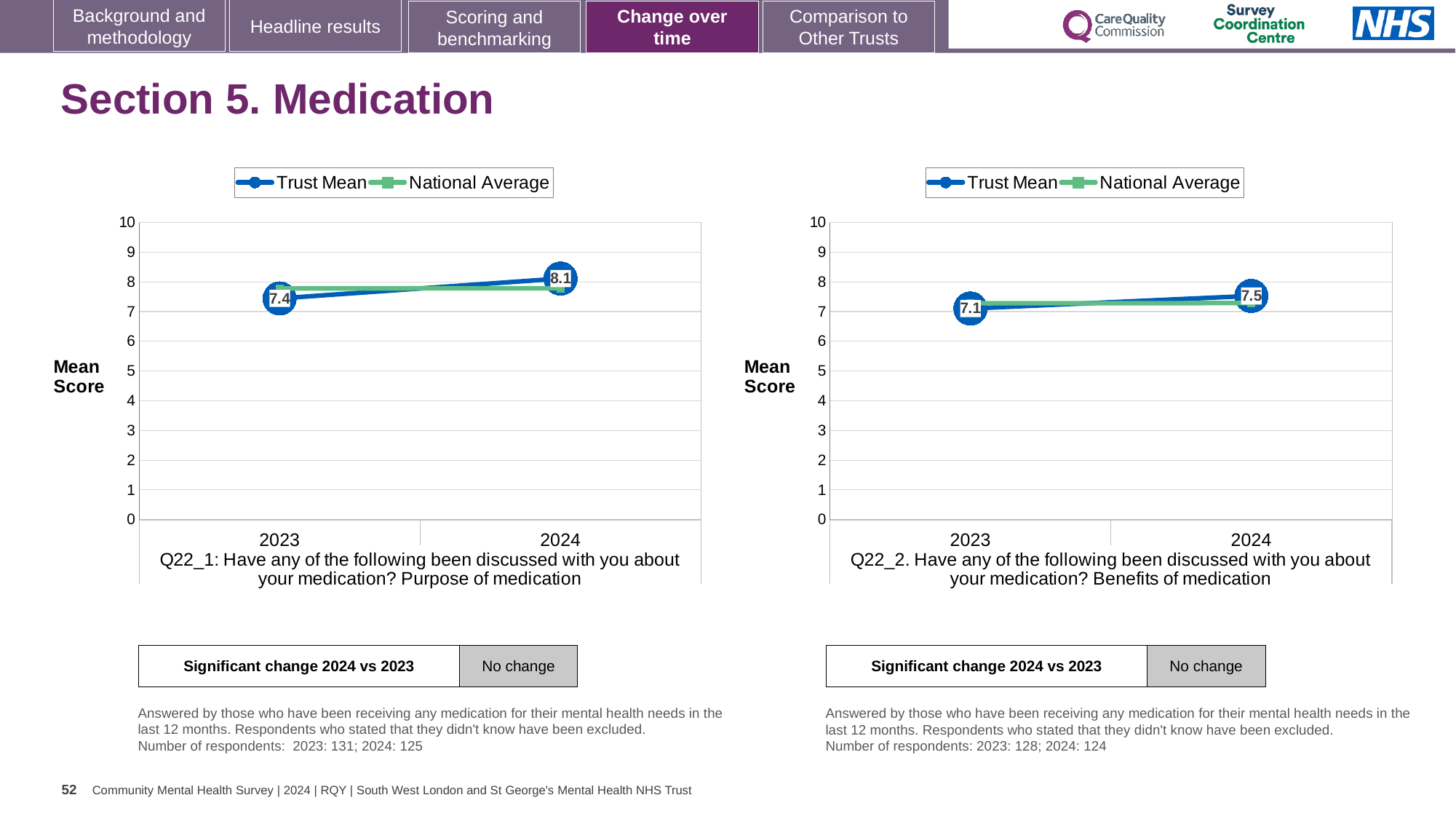
How many series does the legend of the left chart (Q22_1) list? 2 In the right chart (Q22_2: Benefits of medication), what is the Trust Mean for 2024? 7.5 In the right chart (Q22_2: Benefits of medication), is the National Average for 2024 greater or less than 5? greater What kind of chart is used on this slide for Q22_1 and Q22_2? line chart In the right chart (Q22_2: Benefits of medication), what is the difference between the Trust Mean for 2024 and 2023? 0.4 In the left chart (Q22_1: Purpose of medication), by how much did the Trust Mean change from 2023 to 2024? 0.7 In the left chart (Q22_1: Purpose of medication), what is the Trust Mean for 2023? 7.4 In the left chart (Q22_1: Purpose of medication), what is the Trust Mean for 2024? 8.1 In the left chart (Q22_1: Purpose of medication), does the Trust Mean rise or fall from 2023 to 2024? rise In the right chart (Q22_2: Benefits of medication), what is the Trust Mean for 2023? 7.1 How many years are shown on the x axis of the right chart (Q22_2)? 2 In the right chart (Q22_2: Benefits of medication), which year has the higher Trust Mean, 2023 or 2024? 2024